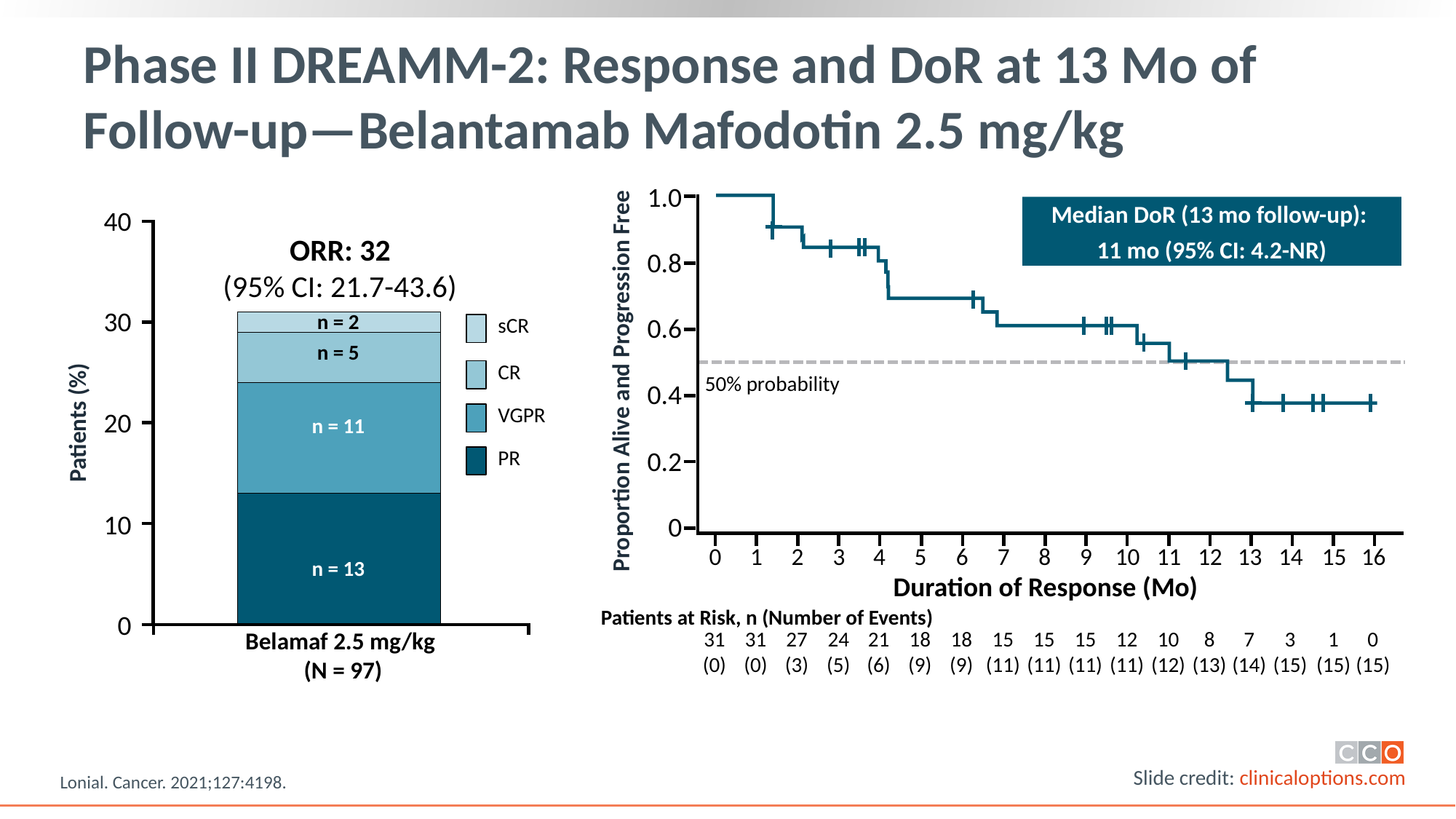
In the right chart, what is the median DoR reported in the box? 11 mo What ORR is shown above the bar in the left chart? 32 In the left bar chart, what is the difference in n between the VGPR and CR segments? 6 What kind of chart is shown on the left of the slide? Stacked bar chart In the left bar chart, which response category has the smallest segment? sCR In the left bar chart, what is the n value for the PR segment? n = 13 In the left bar chart, what is the total n across all four stacked segments? 31 In the right chart, is the proportion alive and progression free at month 5 greater or less than 0.6? greater How many response categories does the legend of the left bar chart list? 4 In the left bar chart, which response category has the largest segment? PR In the left bar chart, what is the n value for the VGPR segment? n = 11 In the right chart, how many patients are at risk at month 0? 31